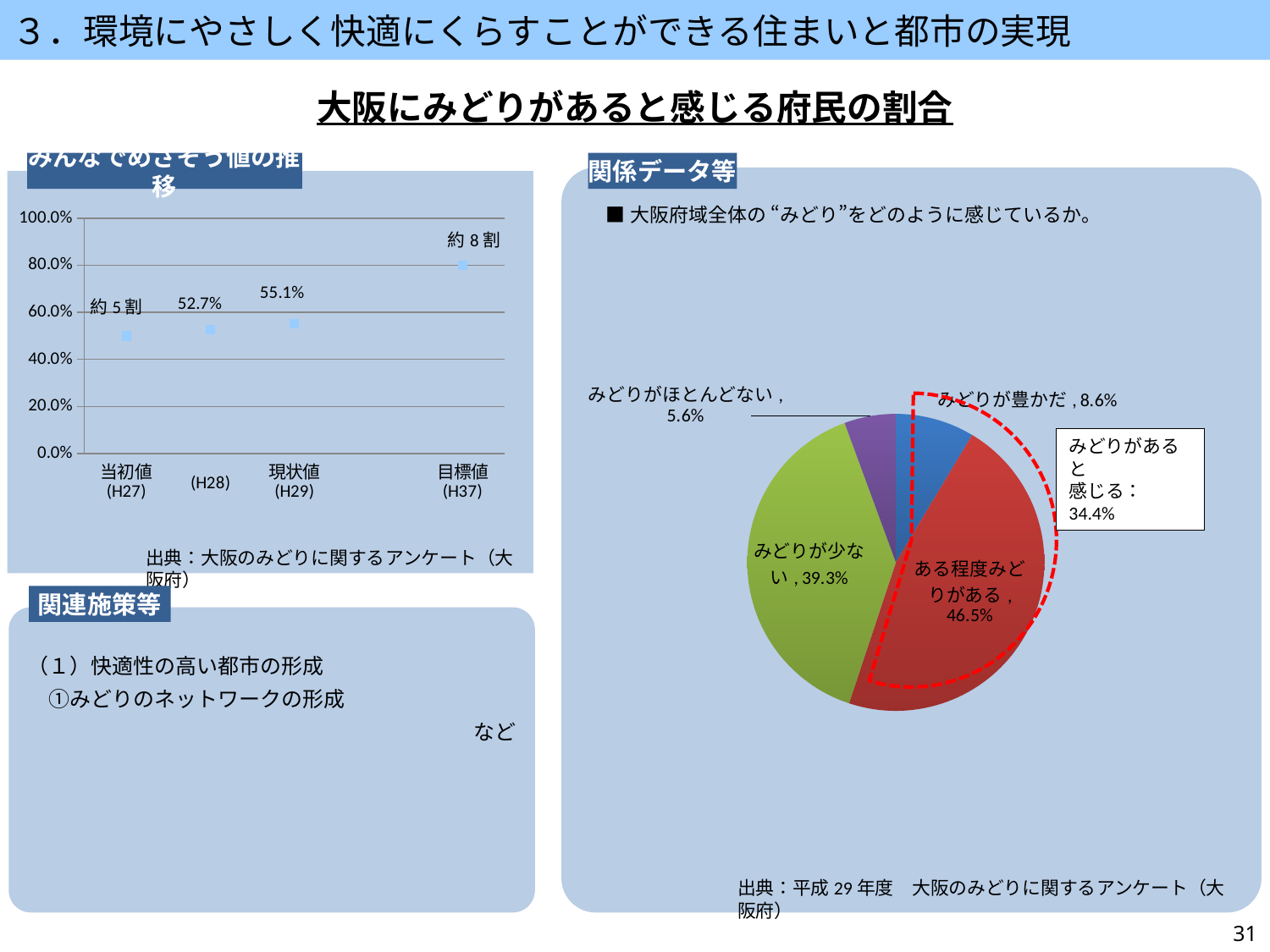
In the right pie chart, what percentage is shown for みどりがほとんどない? 5.6% What type of chart is shown on the right side of the slide? pie chart In the right pie chart, what percentage is shown for ある程度みどりがある? 46.5% In the right pie chart, what is the difference between ある程度みどりがある and みどりが少ない? 7.2% In the right pie chart, which category has the smallest share? みどりがほとんどない In the left chart (みんなでめざそう値の推移), what is the value for 現状値 (H29)? 55.1% In the right pie chart, which category has the largest share? ある程度みどりがある In the left chart (みんなでめざそう値の推移), do the values rise or fall from 当初値 (H27) to 目標値 (H37)? rise In the left chart (みんなでめざそう値の推移), is the value for 当初値 (H27) greater or less than 60%? less In the right pie chart, which is larger: みどりが豊かだ or みどりがほとんどない? みどりが豊かだ In the left chart (みんなでめざそう値の推移), how many data points are plotted? 4 In the left chart (みんなでめざそう値の推移), what is the value for H28? 52.7%